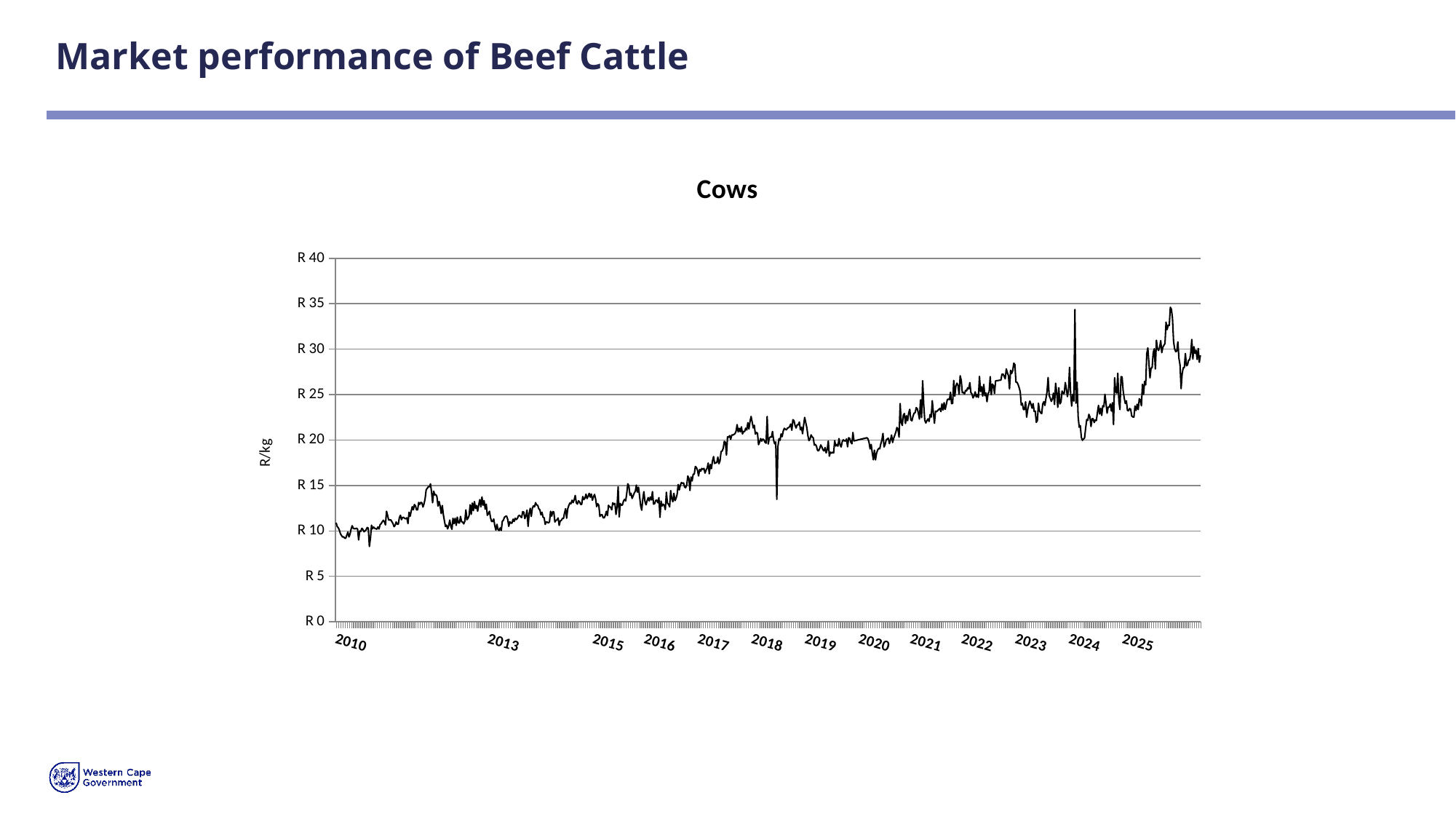
Is the value for cows around 2013 greater or less than R 15? less Is the lowest point on the line greater or less than R 15? less What is the label on the vertical axis of the chart? R/kg Is the highest point on the line greater or less than R 30? greater What is the highest value shown on the vertical axis? R 40 What kind of chart is shown on the slide? line chart Overall, do the values rise or fall from 2010 to 2025? rise What is the title of the chart? Cows Which is larger, the value for cows around 2013 or around 2025? 2025